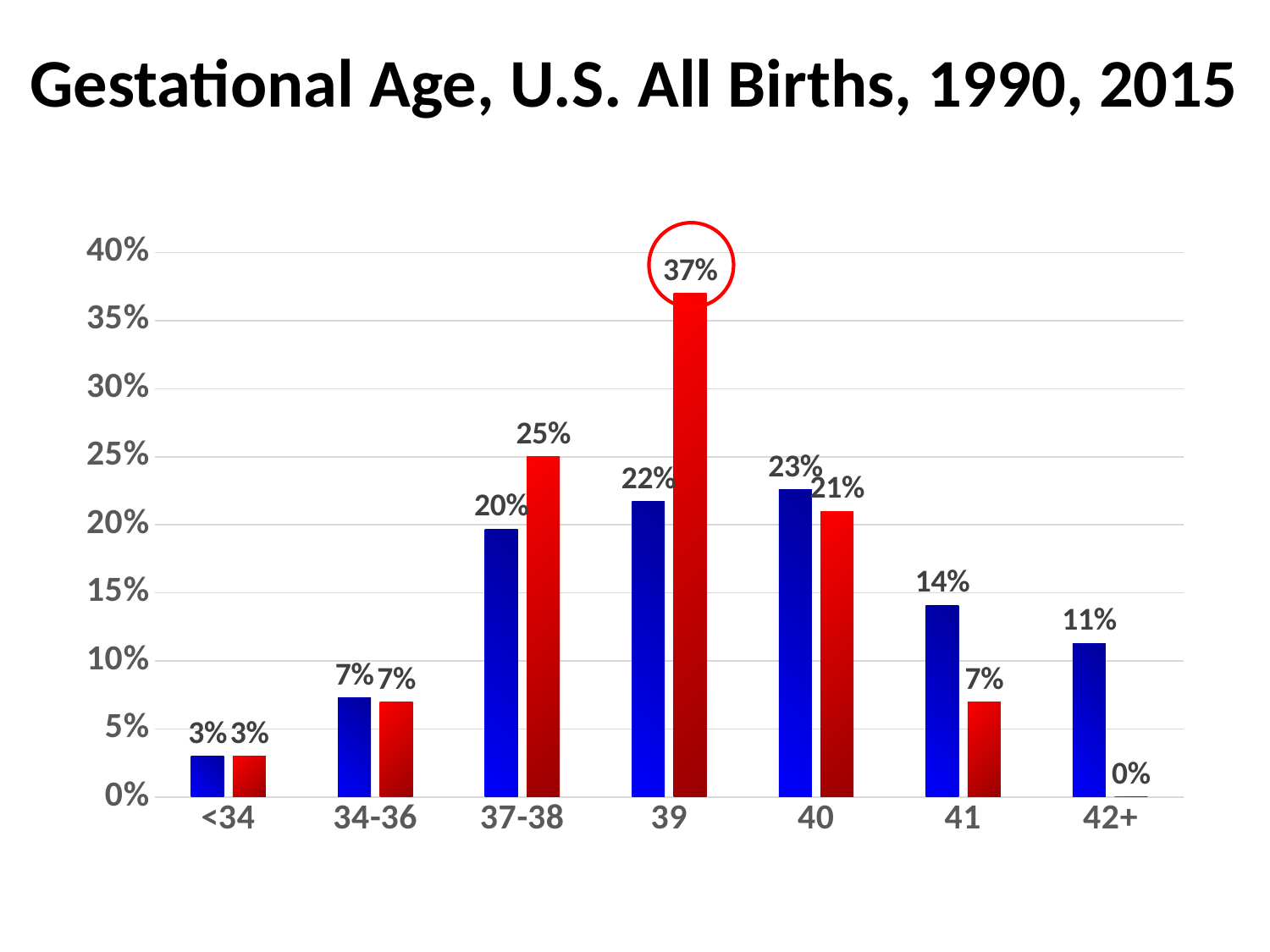
What is the value of the red bar for the 39 category? 37% What kind of chart is shown on the slide? bar chart What is the difference between the blue bar and the red bar for the 41 category? 7% Which category has the highest red bar? 39 Which category has the highest blue bar? 40 What is the value of the blue bar for the 41 category? 14% How many gestational age categories are shown on the x axis? 7 What is the difference between the red bar and the blue bar for the 39 category? 15% For the 40 category, which is larger, the blue bar or the red bar? the blue bar Which data label on the chart is circled in red? 37% What is the value of the blue bar for the 37-38 category? 20% What is the value of the red bar for the 42+ category? 0%